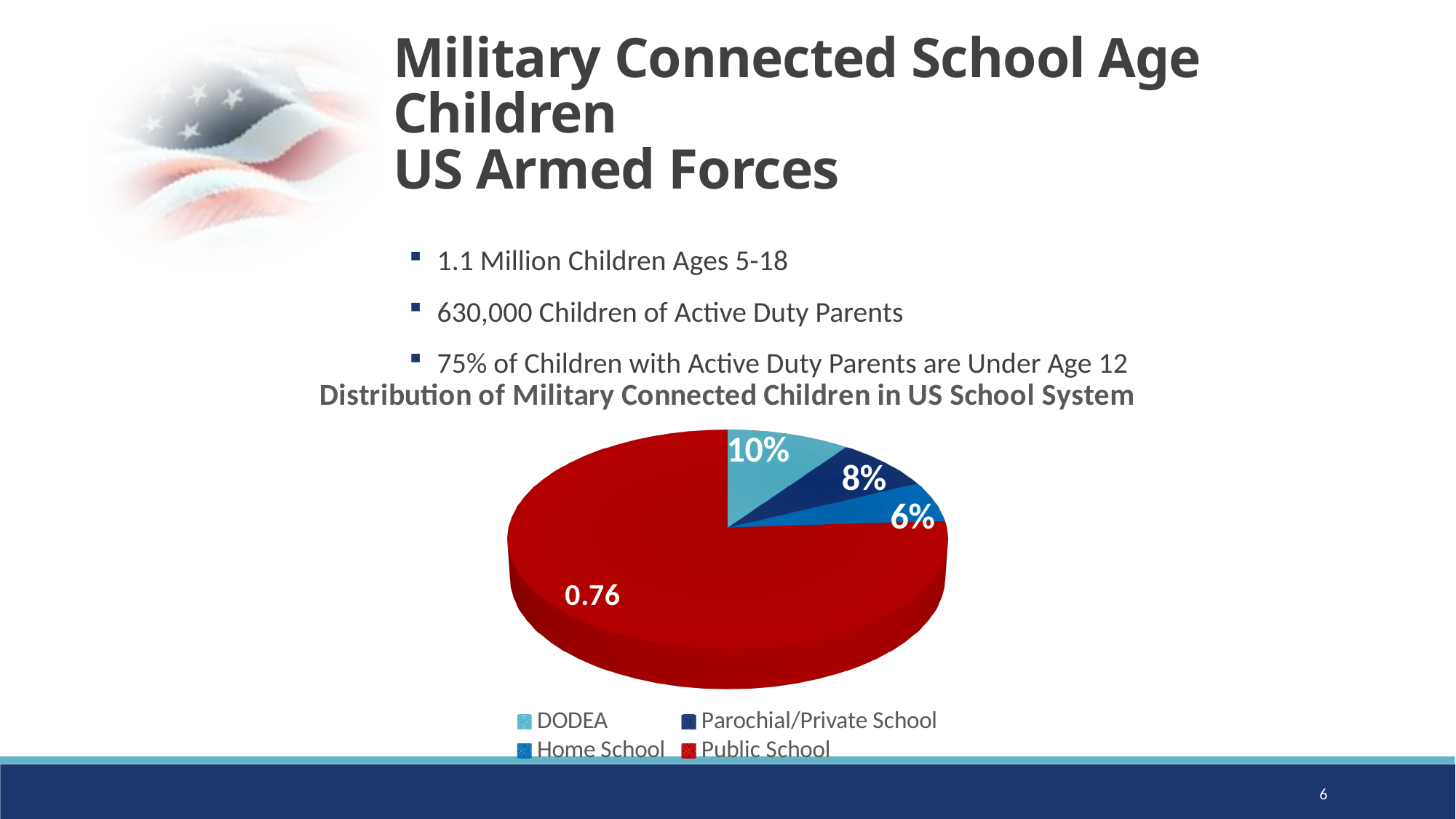
What colour is the Public School slice? Red Which category has the smallest slice of the pie? Home School How many categories does the legend of the pie chart list? 4 Which is larger, the DODEA slice or the Home School slice? DODEA What type of chart is shown on the slide? Pie chart Which category has the largest slice of the pie? Public School What is the chart's title? Distribution of Military Connected Children in US School System What share of the pie is labelled for DODEA? 10% What value is printed on the Public School slice? 0.76 What is the difference between the DODEA share and the Parochial/Private School share? 2% What share of the pie is labelled for Home School? 6% What share of the pie is labelled for Parochial/Private School? 8%